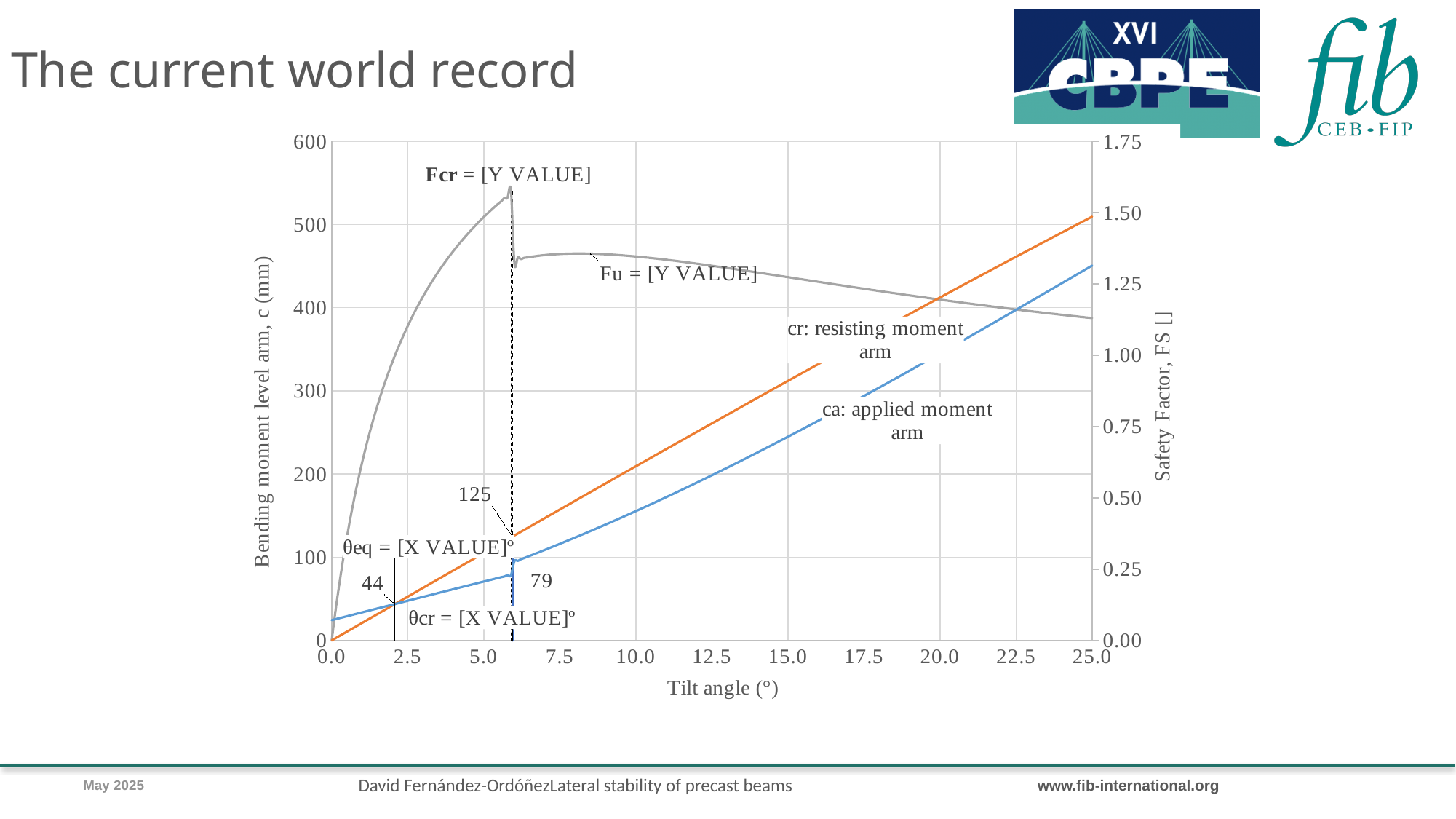
What value is labelled where the 'cr: resisting moment arm' and 'ca: applied moment arm' lines cross? 44 What is the title of the left y axis of the chart? Bending moment level arm, c (mm) At a tilt angle of 25.0°, which line is higher: 'cr: resisting moment arm' or 'ca: applied moment arm'? cr: resisting moment arm At a tilt angle of 25.0°, is the value of the 'ca: applied moment arm' line greater or less than 400? greater What kind of chart is shown on the slide? line chart What value is labelled on the 'cr: resisting moment arm' line at the dashed vertical line near a tilt angle of 6°? 125 How many lines are plotted on the chart? 3 What is the difference between the labelled values 125 and 79 at the dashed vertical line? 46 What is the title of the x axis of the chart? Tilt angle (°) Does the 'cr: resisting moment arm' line rise or fall as the tilt angle increases? rise What value is labelled on the 'ca: applied moment arm' line at the dashed vertical line near a tilt angle of 6°? 79 After its peak near a tilt angle of 8°, does the grey Safety Factor line rise or fall as the tilt angle increases? fall